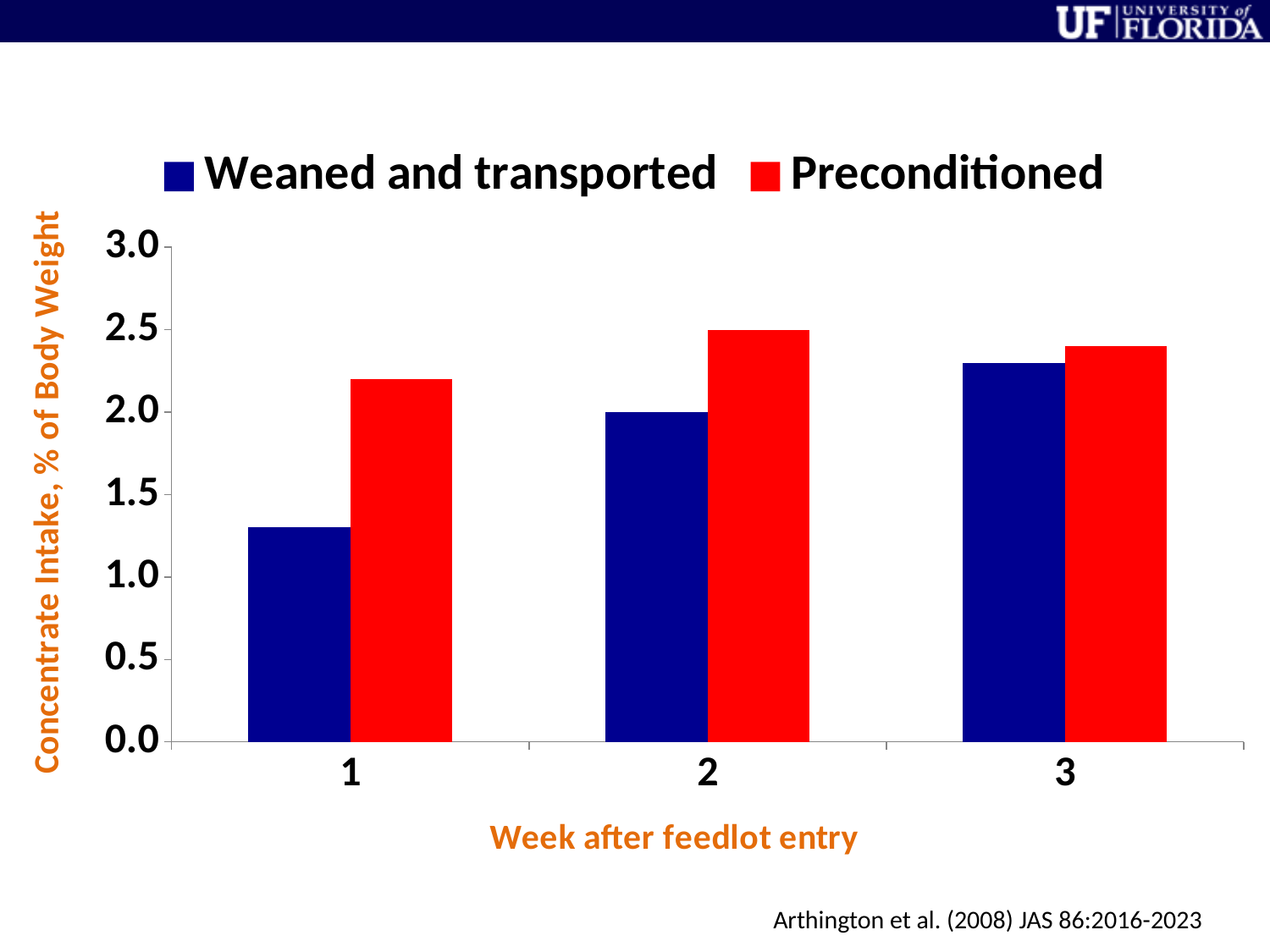
Is the value for Preconditioned in week 1 greater or less than 2.0? greater Do the Weaned and transported values rise or fall from week 1 to week 3? rise Is the value for Preconditioned in week 3 greater or less than 2.5? less What kind of chart is shown on the slide? bar chart How many series does the legend list? 2 What is the y-axis title of the chart? Concentrate Intake, % of Body Weight In which week is the Preconditioned value highest? 2 In week 1, which series has the larger value, Weaned and transported or Preconditioned? Preconditioned How many weeks after feedlot entry are shown on the x axis? 3 Is the value for Weaned and transported in week 1 greater or less than 1.5? less Which series is shown in red in the legend? Preconditioned